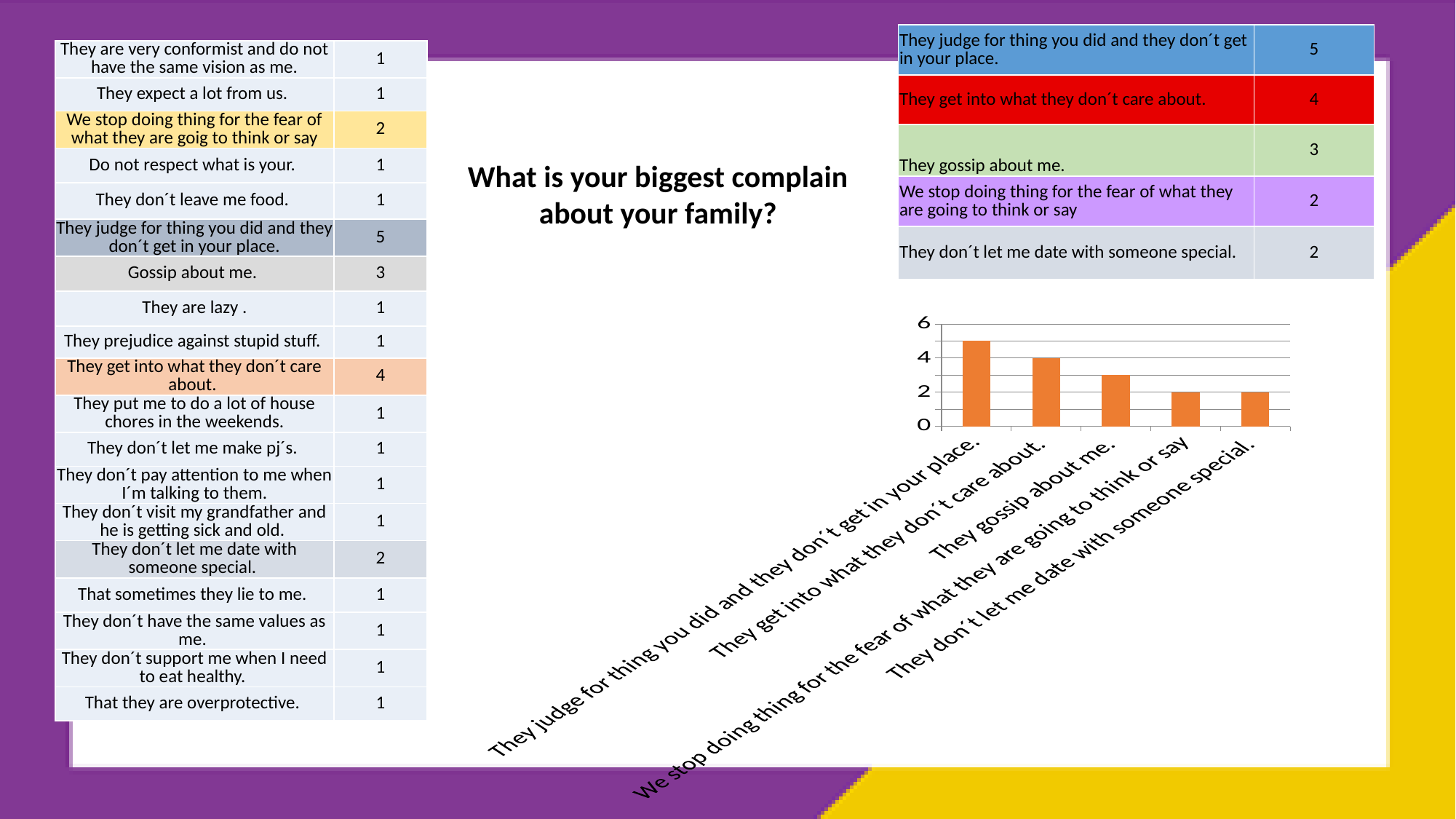
Is the value for "They gossip about me." greater or less than 4? less What kind of chart is shown on the slide? bar chart What is the difference between the bar for "They get into what they don´t care about." and the bar for "They don´t let me date with someone special."? 2 How many categories (bars) does the chart show? 5 Which category has the highest bar in the chart? They judge for thing you did and they don´t get in your place. What colour are the bars in the chart? orange What is the value of the bar for "They get into what they don´t care about."? 4 What is the value of the bar for "We stop doing thing for the fear of what they are going to think or say"? 2 Is the value for "They judge for thing you did and they don´t get in your place." greater or less than 4? greater What is the value of the bar for "They don´t let me date with someone special."? 2 Do the bar values rise or fall from left to right along the x axis? fall Which is larger: the bar for "They get into what they don´t care about." or the bar for "They gossip about me."? They get into what they don´t care about.